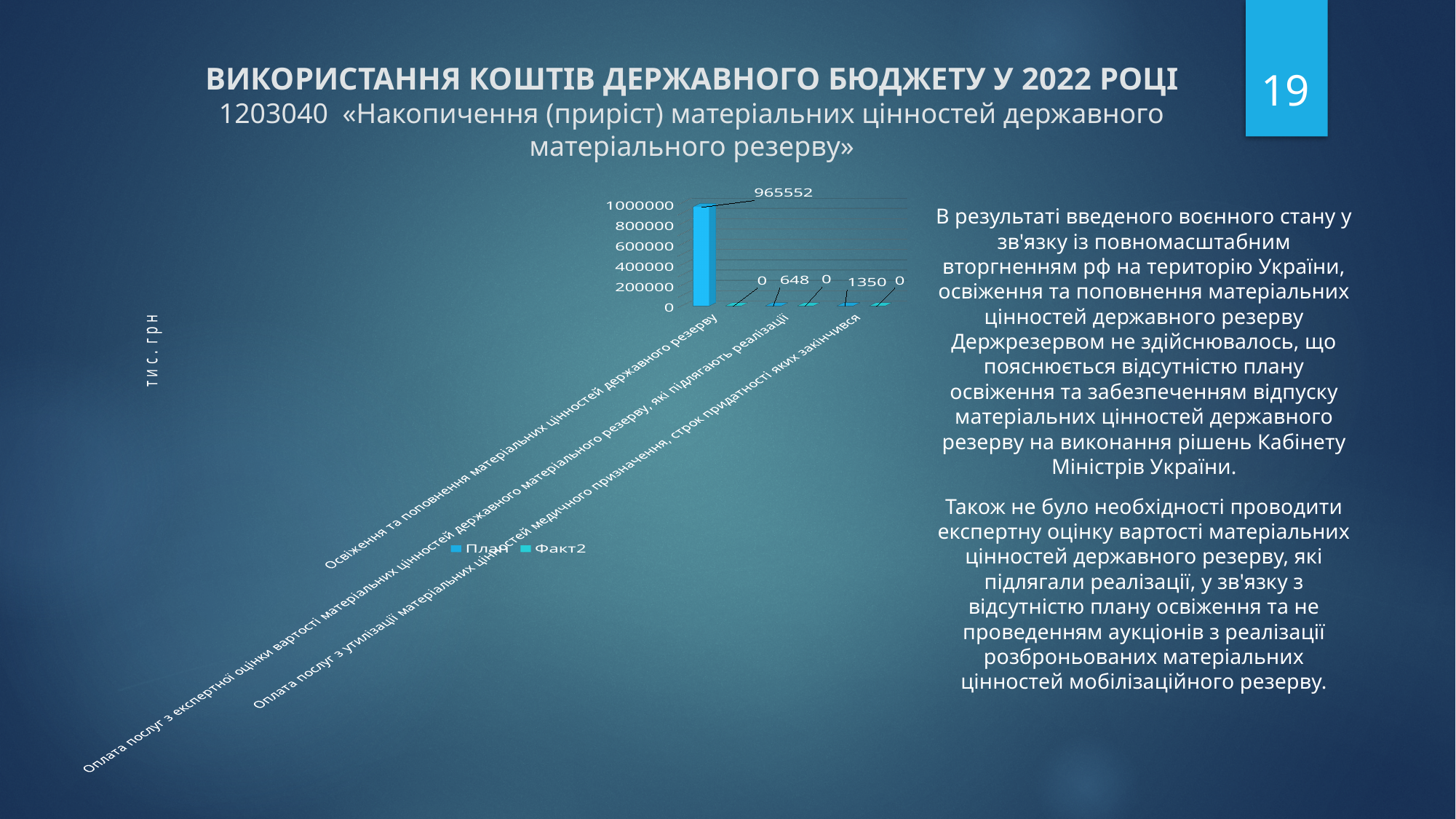
Is the План value for «Освіження та поповнення матеріальних цінностей державного резерву» greater or less than 800000? greater Which category has the lowest План value? Оплата послуг з експертної оцінки вартості матеріальних цінностей державного матеріального резерву, які підлягають реалізації How many categories are shown on the x axis of the chart? 3 What is the difference between the План values for «Оплата послуг з утилізації матеріальних цінностей медичного призначення, строк придатності яких закінчився» and «Оплата послуг з експертної оцінки вартості матеріальних цінностей державного матеріального резерву, які підлягають реалізації»? 702 What is the План value for «Освіження та поповнення матеріальних цінностей державного резерву»? 965552 What is the План value for «Оплата послуг з утилізації матеріальних цінностей медичного призначення, строк придатності яких закінчився»? 1350 What is the План value for «Оплата послуг з експертної оцінки вартості матеріальних цінностей державного матеріального резерву, які підлягають реалізації»? 648 Which category has the highest План value? Освіження та поповнення матеріальних цінностей державного резерву Which is larger: the План value for «Оплата послуг з утилізації матеріальних цінностей медичного призначення, строк придатності яких закінчився» or the План value for «Оплата послуг з експертної оцінки вартості матеріальних цінностей державного матеріального резерву, які підлягають реалізації»? Оплата послуг з утилізації матеріальних цінностей медичного призначення, строк придатності яких закінчився What type of chart is shown on the slide? bar chart What is the Факт2 value for «Освіження та поповнення матеріальних цінностей державного резерву»? 0 How many series does the chart legend list? 2